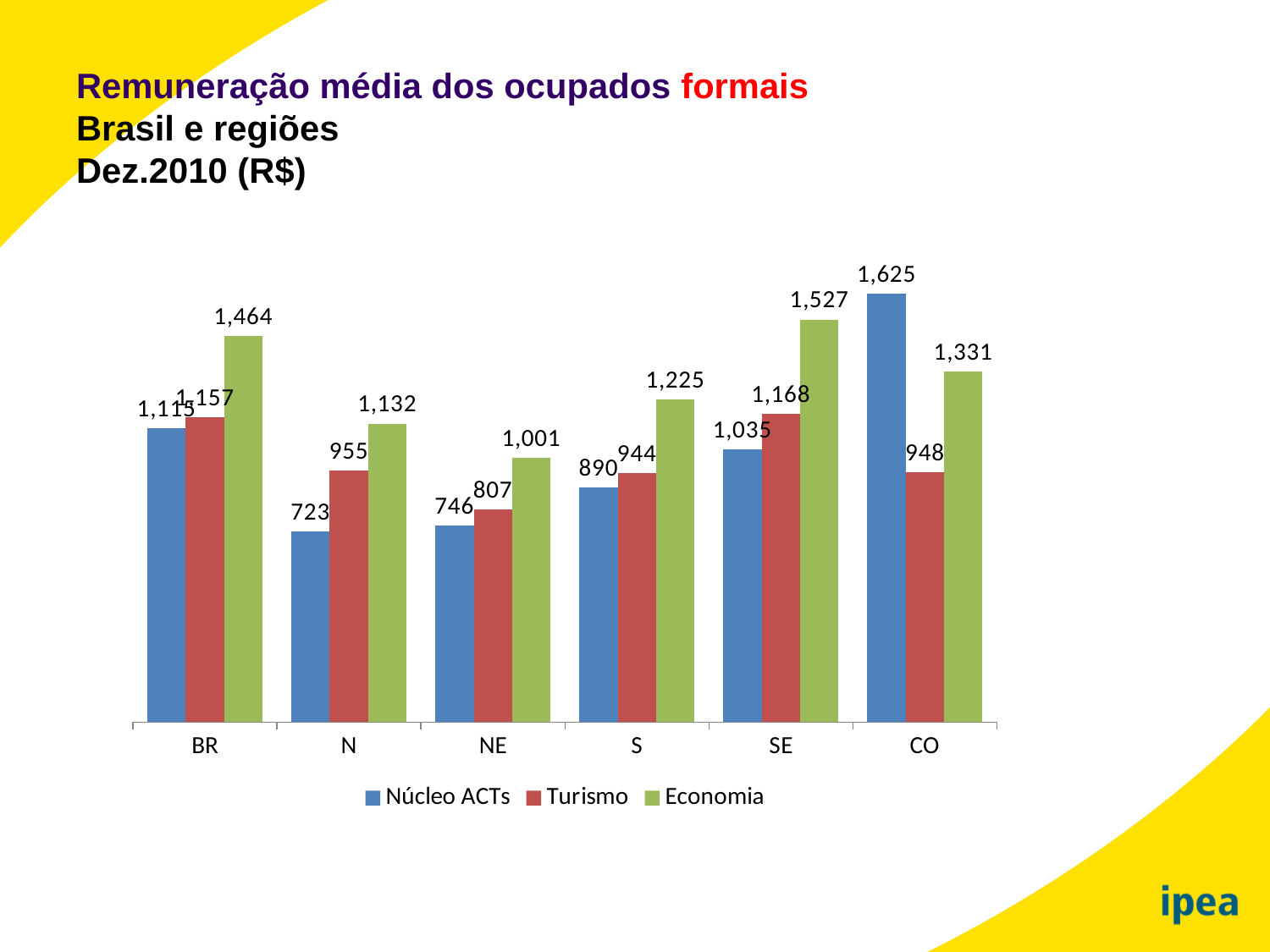
What is the value for Economia in the NE region? 1,001 Which region has the lowest value for Turismo? NE Which region has the highest value for Núcleo ACTs? CO What kind of chart is shown on the slide? Bar chart What is the value for Economia in the SE region? 1,527 Which is larger in the CO region, Turismo or Economia? Economia Which series is shown in green in the legend? Economia How many series does the legend list? 3 What is the difference between the Economia and Turismo values in the S region? 281 How many regions (categories) are shown on the x axis? 6 What is the value for Núcleo ACTs in the CO region? 1,625 What is the value for Turismo in the N region? 955